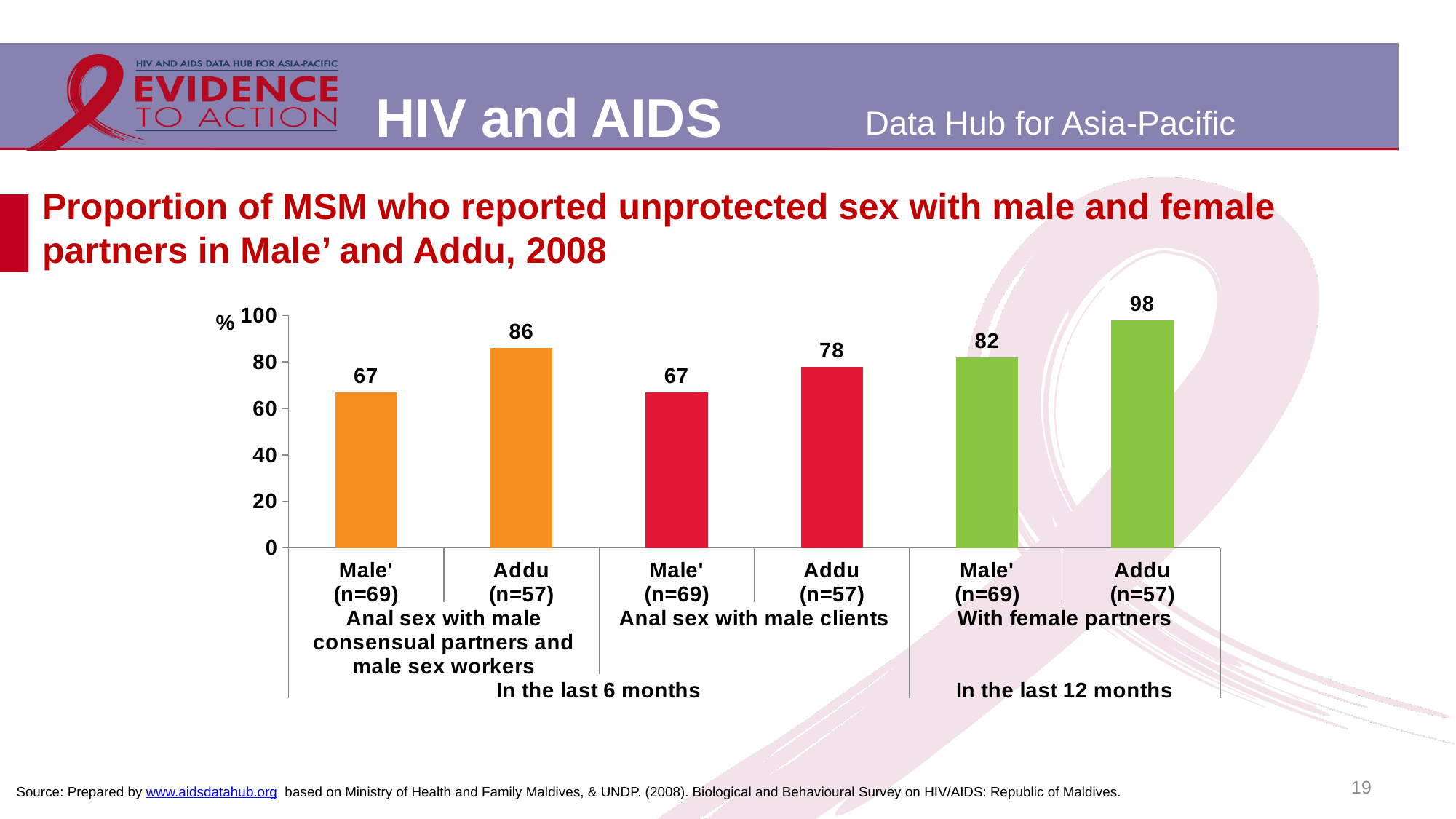
What is the difference between Addu and Male' for anal sex with male clients? 11 What type of chart is shown on the slide? Bar chart How many bars are plotted in the chart? 6 Which is larger: the value for Addu for anal sex with male consensual partners and male sex workers, or the value for Addu for anal sex with male clients? Anal sex with male consensual partners and male sex workers (86) What is the lowest value shown in the chart? 67 What is the value for Addu (n=57) for unprotected sex with female partners in the last 12 months? 98 What is the maximum value shown on the y axis of the chart? 100 What is the value for Male' (n=69) for anal sex with male clients in the last 6 months? 67 Which bar has the highest value in the chart? Addu (n=57), with female partners What is the difference between Addu and Male' for unprotected sex with female partners? 16 What is the value for Addu (n=57) for anal sex with male consensual partners and male sex workers in the last 6 months? 86 What is the value for Male' (n=69) for unprotected sex with female partners in the last 12 months? 82